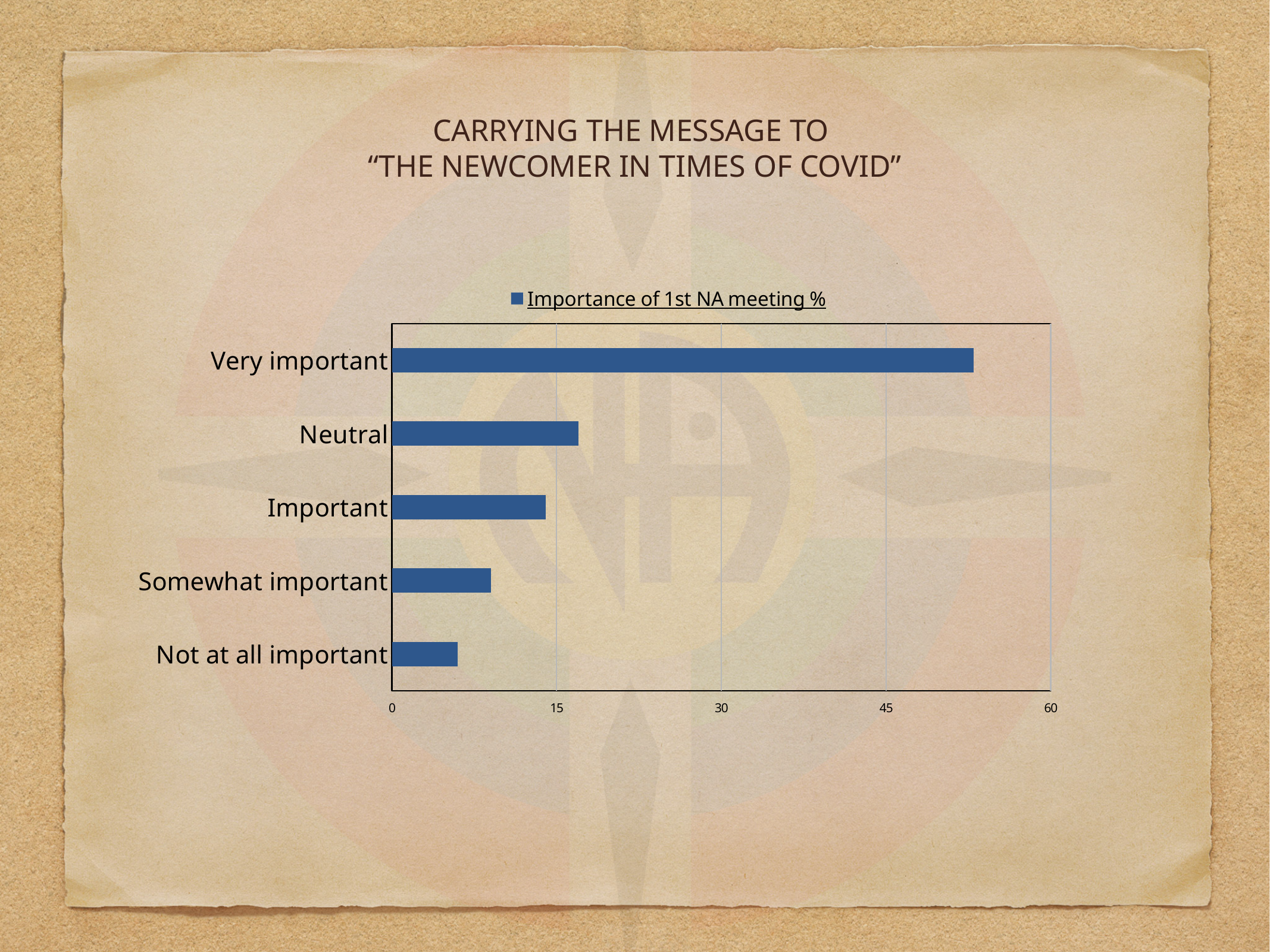
Which is larger, the value for Somewhat important or the value for Not at all important? Somewhat important Which category has the highest value? Very important Is the value for Very important greater or less than 45? greater How many series does the legend list? 1 Is the value for Not at all important greater or less than 15? less Is the value for Somewhat important greater or less than 15? less Which is larger, the value for Very important or the value for Neutral? Very important Which category has the lowest value? Not at all important What series name is shown in the chart legend? Importance of 1st NA meeting % What kind of chart is shown on the slide? bar chart How many categories are plotted in the chart? 5